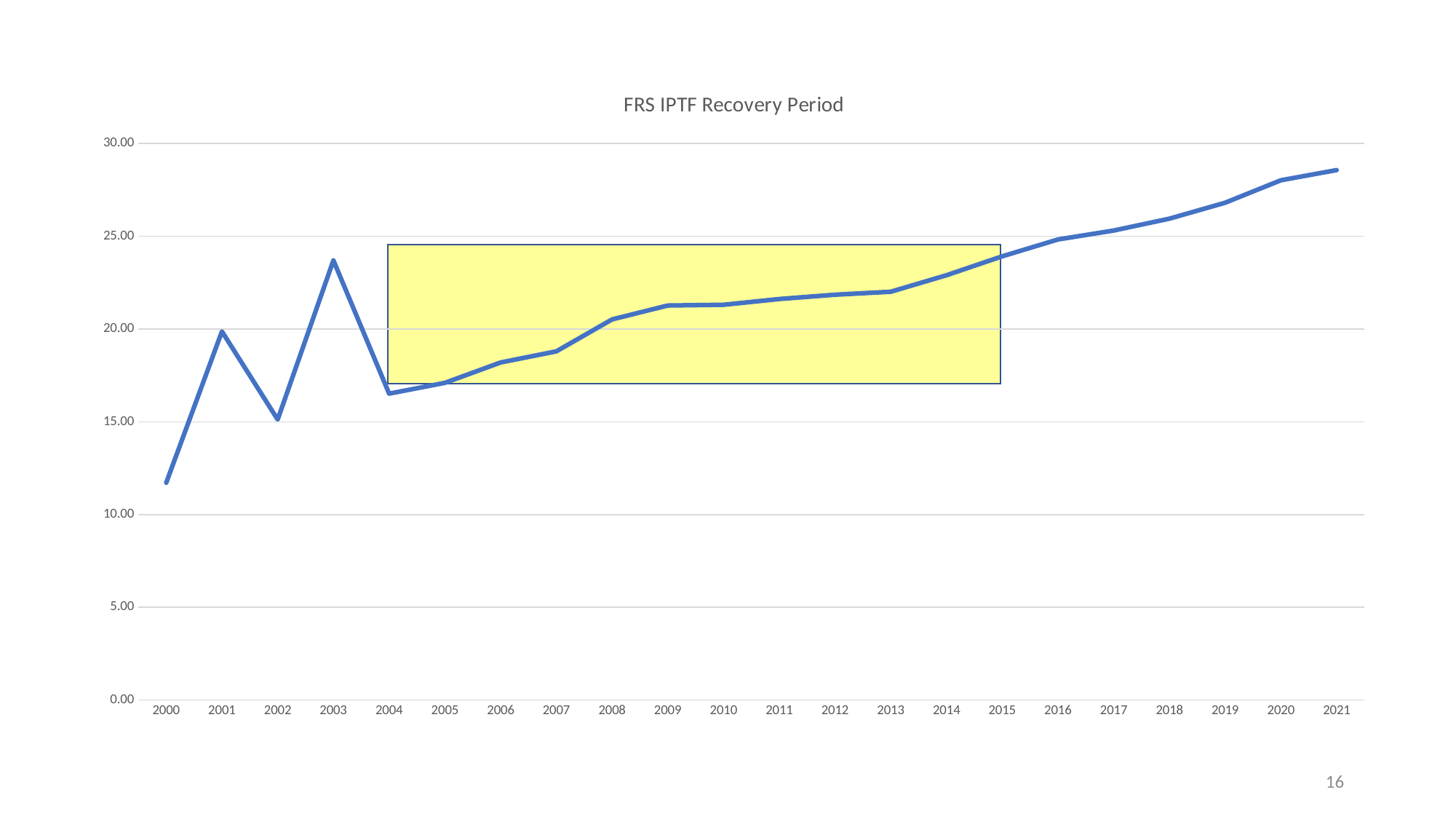
Which year has the larger value, 2002 or 2003? 2003 Which range of years does the yellow highlighted box on the chart cover? 2004 to 2015 Is the value for 2003 greater or less than 25.00? less Is the value for 2013 greater or less than 20.00? greater Is the value for 2000 greater or less than 15.00? less What is the title of the chart? FRS IPTF Recovery Period Which year has the lowest value in the chart? 2000 What kind of chart is shown on the slide? Line chart Do the values rise or fall along the x axis from 2004 to 2021? Rise Which year has the highest value in the chart? 2021 How many years are plotted along the x axis of the chart? 22